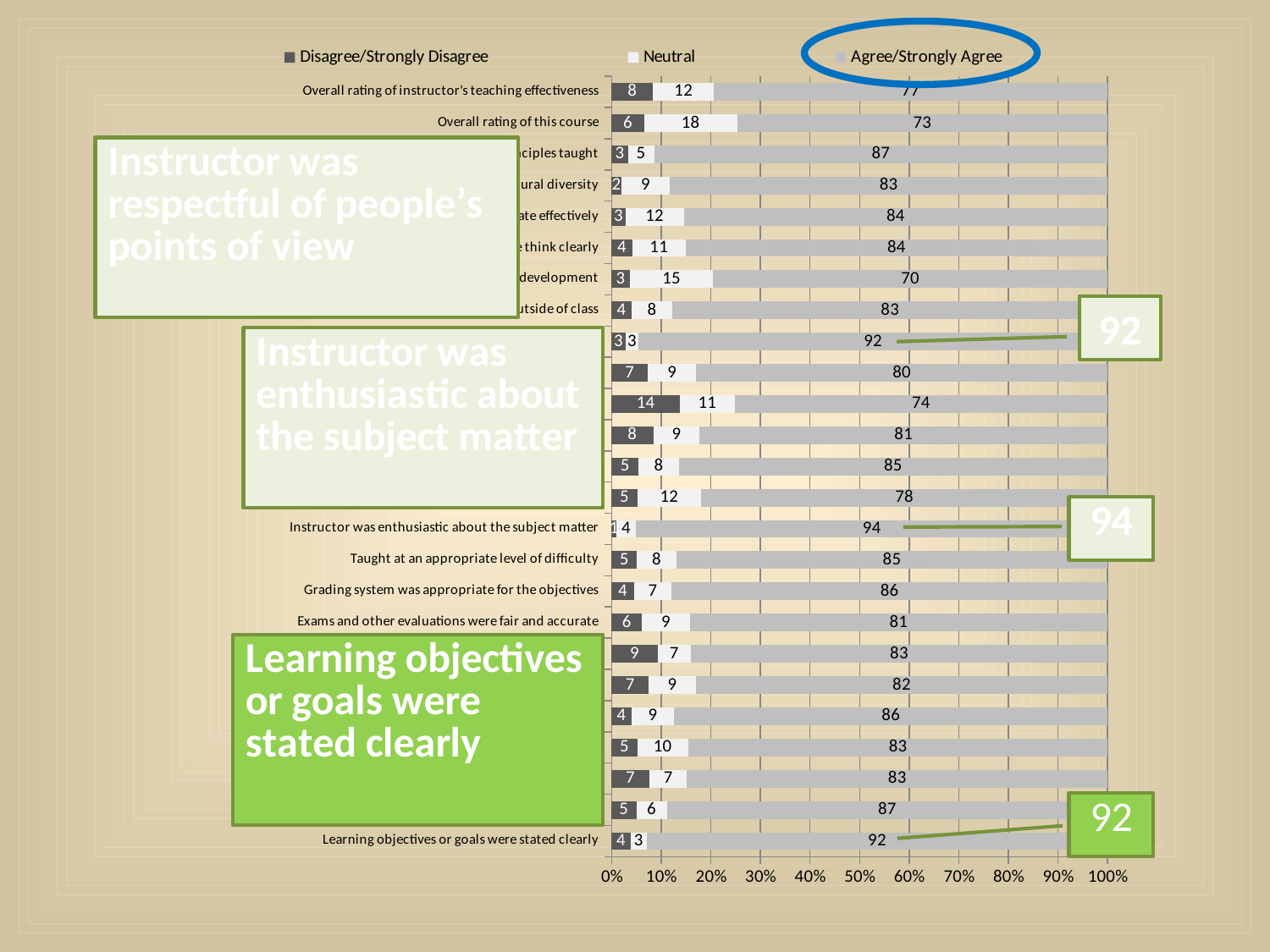
What is the Neutral value for "Exams and other evaluations were fair and accurate"? 9 What is the difference between the Agree/Strongly Agree values for "Learning objectives or goals were stated clearly" and "Overall rating of this course"? 19 What is the Neutral value for "Overall rating of this course"? 18 Which has the larger Agree/Strongly Agree value: "Taught at an appropriate level of difficulty" or "Exams and other evaluations were fair and accurate"? Taught at an appropriate level of difficulty How many series does the legend list? 3 What is the Agree/Strongly Agree value for "Grading system was appropriate for the objectives"? 86 What is the Agree/Strongly Agree value for "Overall rating of this course"? 73 What is the Agree/Strongly Agree value for "Instructor was enthusiastic about the subject matter"? 94 What is the total of the stacked bar for "Learning objectives or goals were stated clearly"? 99 Which category has the highest Agree/Strongly Agree value? Instructor was enthusiastic about the subject matter What kind of chart is shown on the slide? bar chart What is the Disagree/Strongly Disagree value for "Overall rating of instructor's teaching effectiveness"? 8